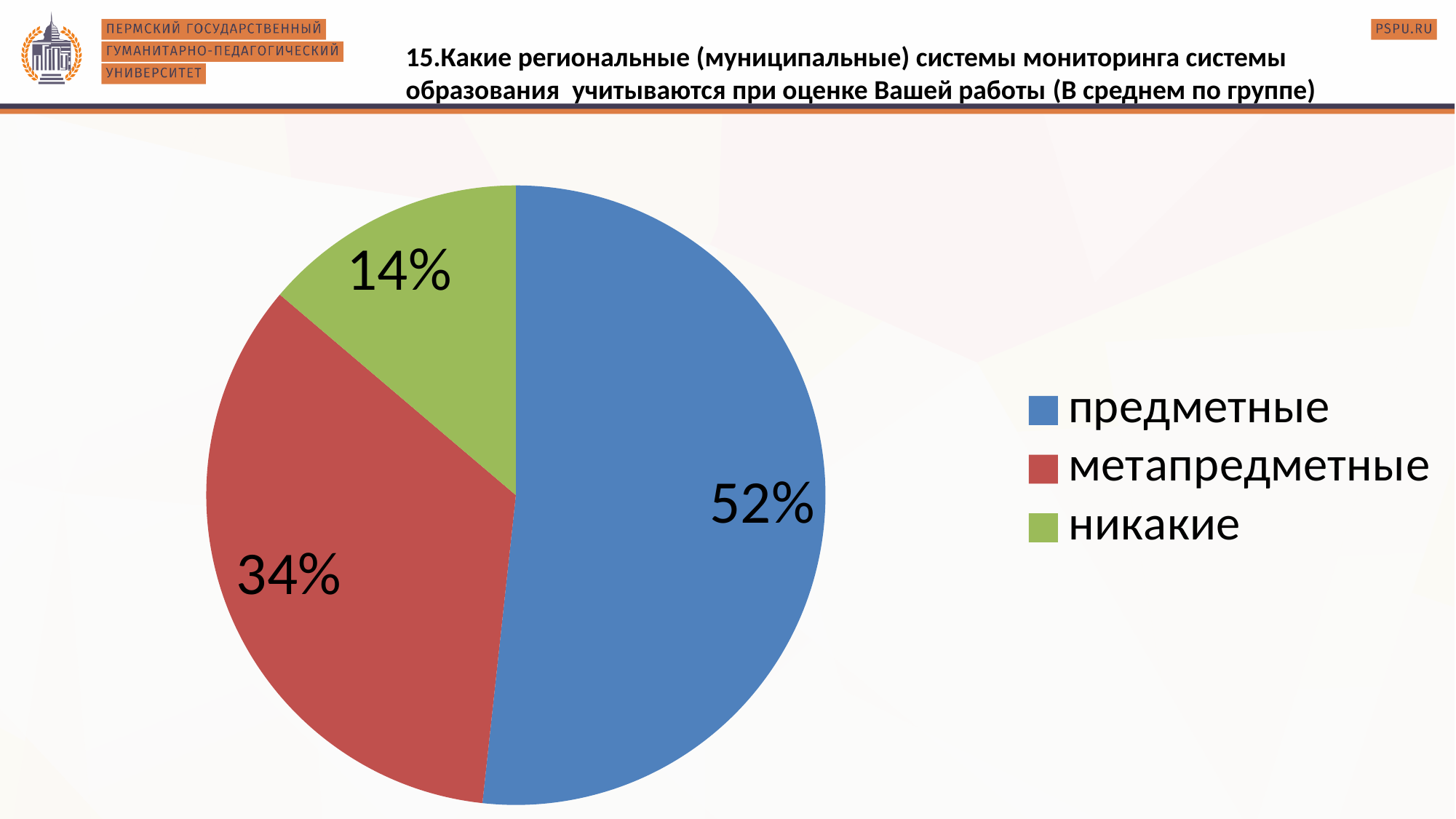
What share of the pie is labelled "никакие"? 14% What kind of chart is shown on the slide? pie chart What is the difference in percentage points between "предметные" and "метапредметные"? 18 Which category has the largest slice of the pie? предметные What share of the pie is labelled "предметные"? 52% What is the difference in percentage points between "метапредметные" and "никакие"? 20 Which is larger, the slice for "метапредметные" or the slice for "никакие"? метапредметные What colour is the slice for "никакие"? green How many entries does the legend list? 3 Which category has the smallest slice of the pie? никакие What share of the pie is labelled "метапредметные"? 34% How many slices does the pie chart have? 3